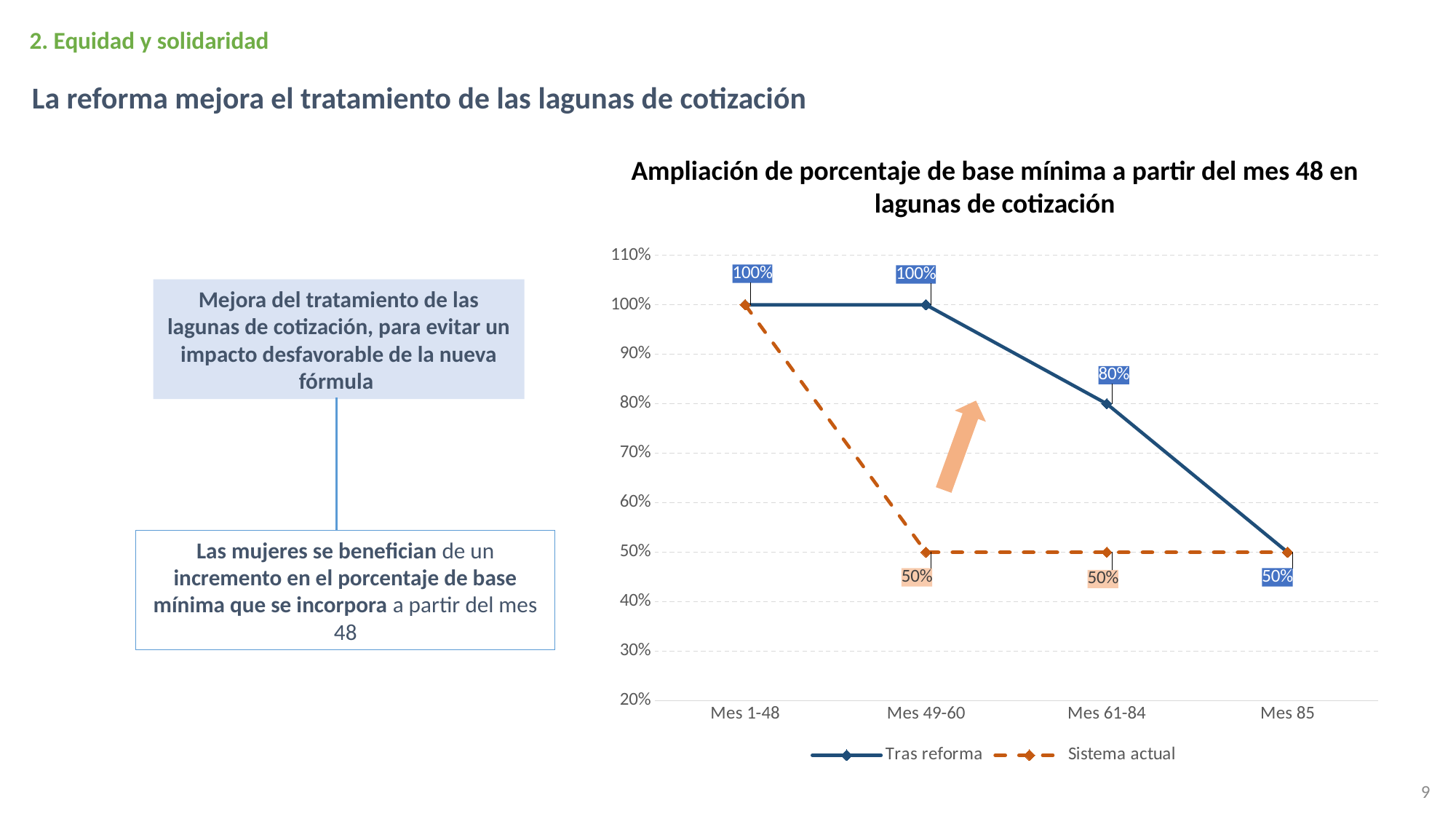
What is the value for 'Tras reforma' at Mes 61-84? 80% What is the title of the chart? Ampliación de porcentaje de base mínima a partir del mes 48 en lagunas de cotización Does the 'Tras reforma' series rise or fall from Mes 49-60 to Mes 85? fall What is the difference between 'Tras reforma' and 'Sistema actual' at Mes 49-60? 50% What is the value for 'Tras reforma' at Mes 85? 50% What is the value for 'Tras reforma' at Mes 49-60? 100% What is the value for 'Sistema actual' at Mes 49-60? 50% How many series does the legend list? 2 Which series has the higher value at Mes 61-84, 'Tras reforma' or 'Sistema actual'? Tras reforma What is the difference between 'Tras reforma' and 'Sistema actual' at Mes 61-84? 30% What type of chart is shown on the slide? line chart How many categories are shown on the x axis? 4